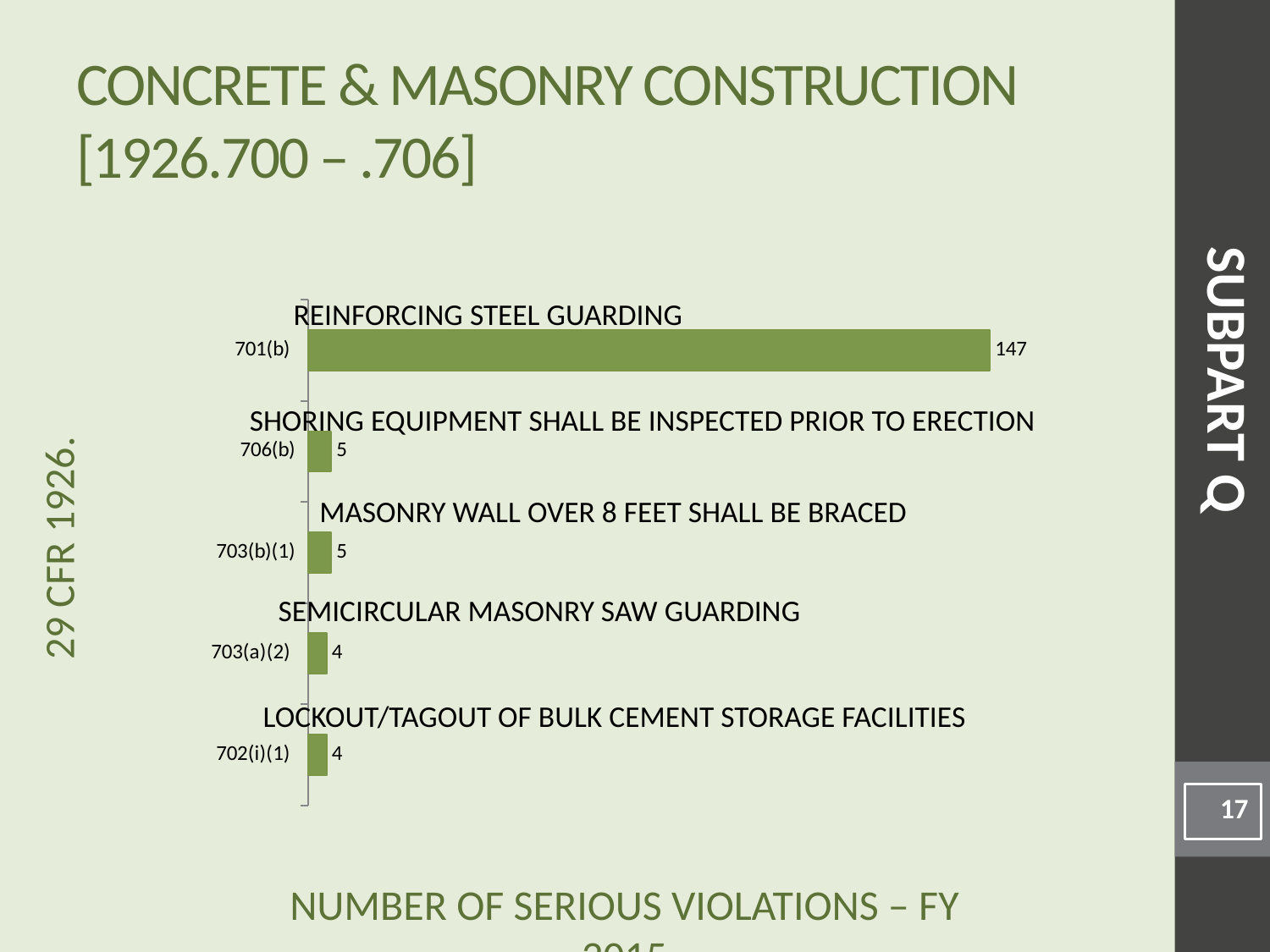
What is the number of serious violations for 701(b)? 147 What is the number of serious violations for 706(b)? 5 What is the number of serious violations for 702(i)(1)? 4 How many categories are shown in the chart? 5 What is the total of all the values shown in the chart? 165 Which category has the highest number of serious violations? 701(b) Which is larger, the value for 701(b) or the value for 703(b)(1)? 701(b) What kind of chart is shown on the slide? Bar chart What is the difference between the values for 701(b) and 706(b)? 142 What is the difference between the values for 703(b)(1) and 703(a)(2)? 1 Which standard is described as REINFORCING STEEL GUARDING? 701(b) What is the number of serious violations for 703(a)(2)? 4